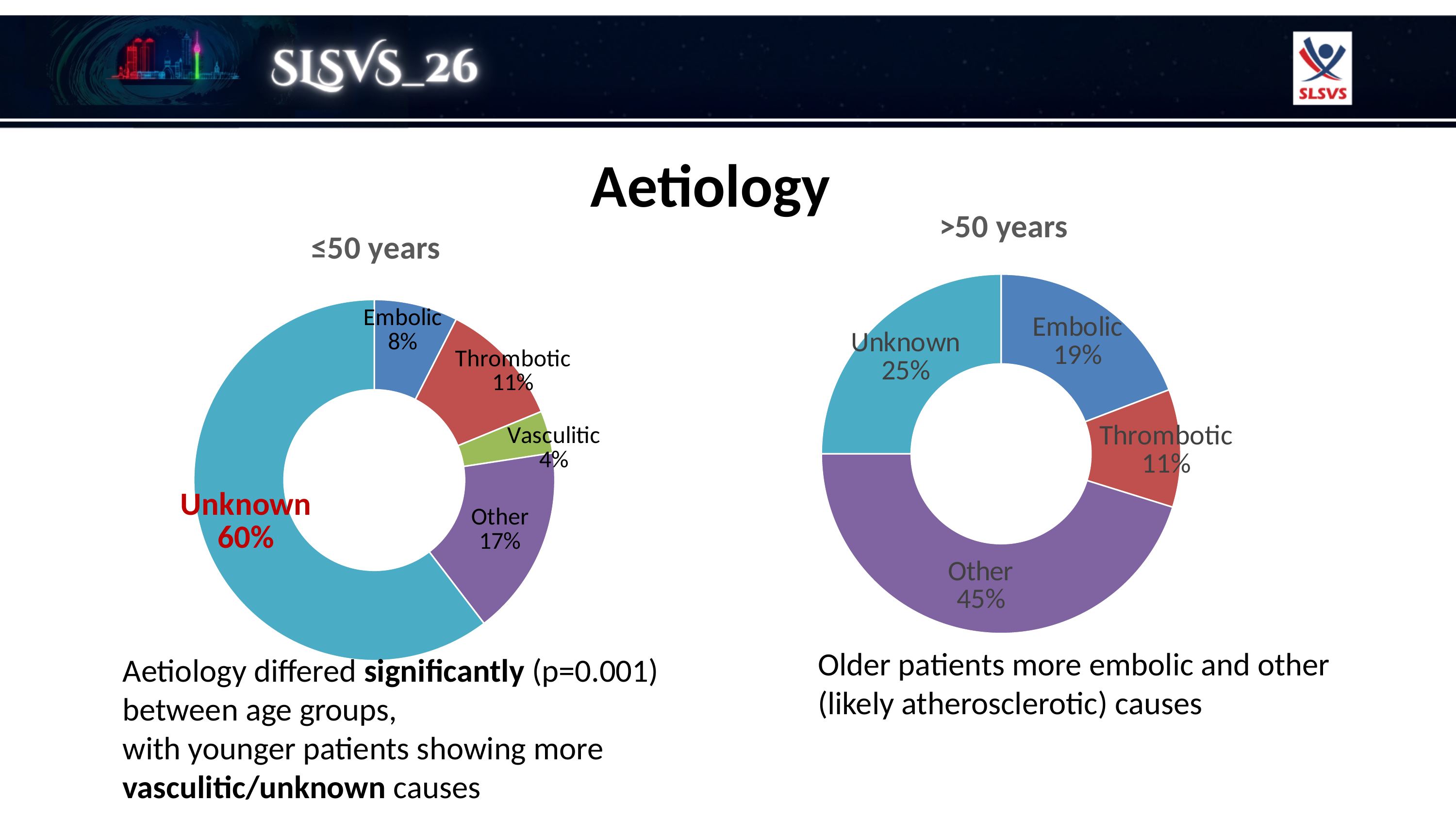
In the ≤50 years chart, what percentage is labelled for Unknown? 60% What type of chart is the ≤50 years chart? Doughnut chart In the >50 years chart, what percentage is labelled for Other? 45% How many categories are shown in the >50 years chart? 4 Which is larger: the Embolic share in the ≤50 years chart or the Embolic share in the >50 years chart? >50 years What is the difference between the Unknown share in the ≤50 years chart and the Unknown share in the >50 years chart? 35% In the ≤50 years chart, which category has the smallest share? Vasculitic In the ≤50 years chart, which category has the largest share? Unknown In the >50 years chart, which category has the smallest share? Thrombotic How many categories are shown in the ≤50 years chart? 5 In the >50 years chart, what percentage is labelled for Embolic? 19% In the ≤50 years chart, what percentage is labelled for Vasculitic? 4%